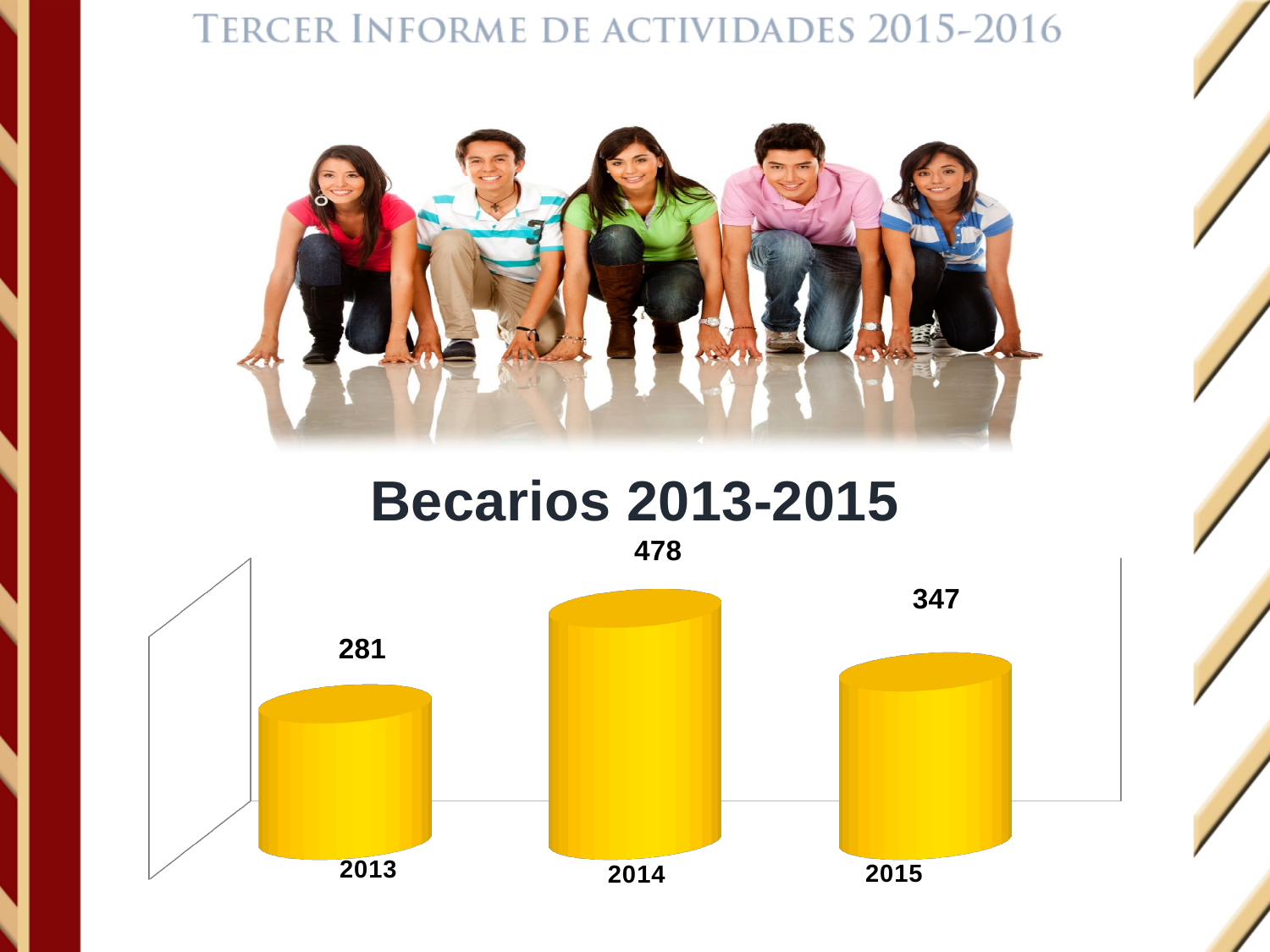
How many years are shown in the chart? 3 Which is larger, the value for 2015 or the value for 2013? 2015 Which year has the highest value? 2014 What is the value for 2014? 478 What kind of chart is shown? bar chart What is the title of the chart? Becarios 2013-2015 Which year has the lowest value? 2013 What is the value for 2015? 347 What is the difference between the values for 2014 and 2013? 197 What is the difference between the values for 2015 and 2013? 66 What is the difference between the values for 2014 and 2015? 131 What is the value for 2013? 281